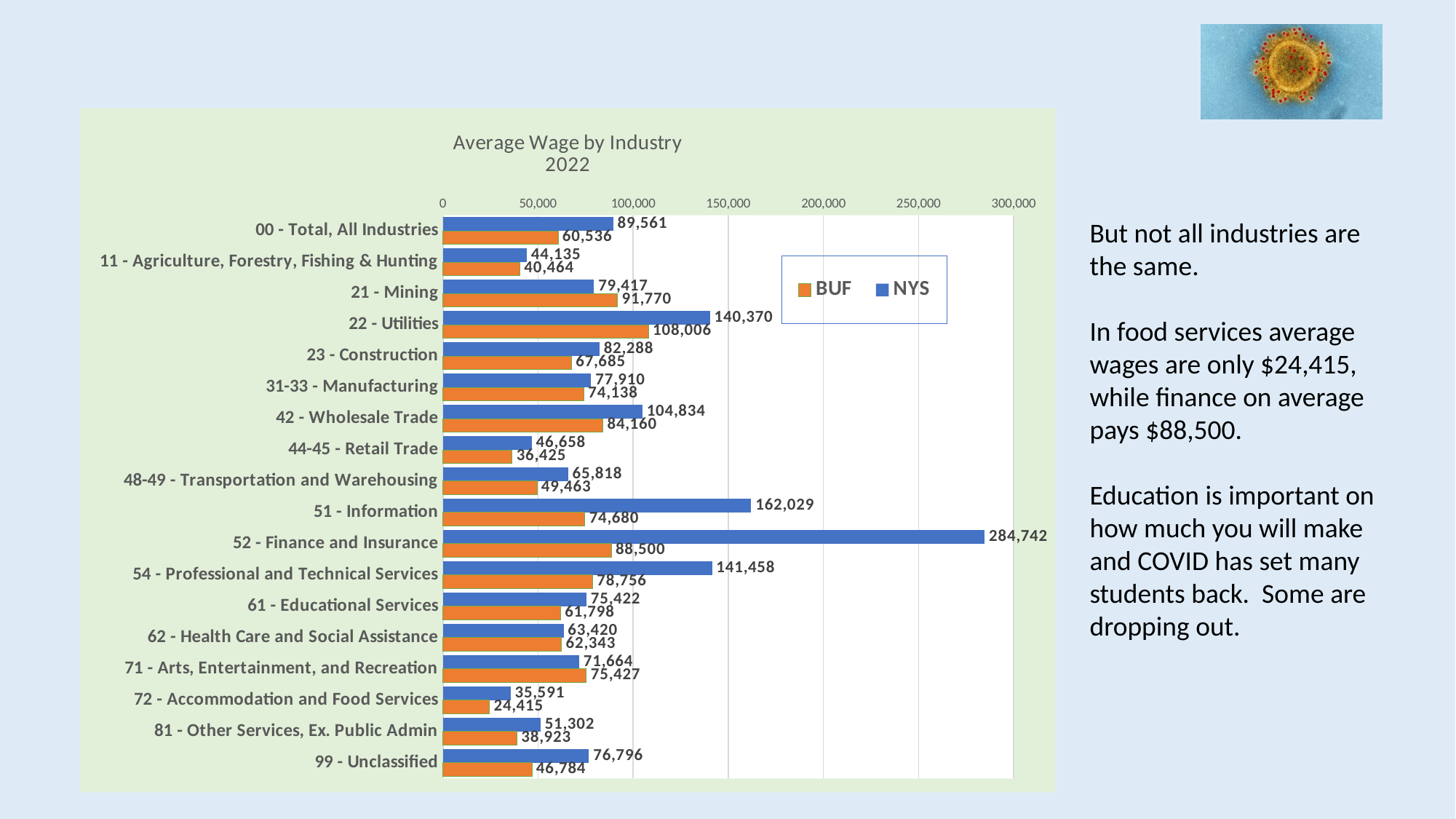
Which industry has the highest NYS average wage? 52 - Finance and Insurance What is the title of the chart? Average Wage by Industry 2022 What kind of chart is shown on the slide? Bar chart What is the BUF average wage for 22 - Utilities? 108,006 What is the difference between the NYS and BUF average wages for 52 - Finance and Insurance? 196,242 How many industry categories are shown on the chart? 18 Is the NYS average wage for 51 - Information greater or less than 150,000? greater What is the BUF average wage for 72 - Accommodation and Food Services? 24,415 How many series does the legend list? 2 Which industry has the lowest BUF average wage? 72 - Accommodation and Food Services For 21 - Mining, which is larger, the BUF or the NYS average wage? BUF What is the NYS average wage for 52 - Finance and Insurance? 284,742